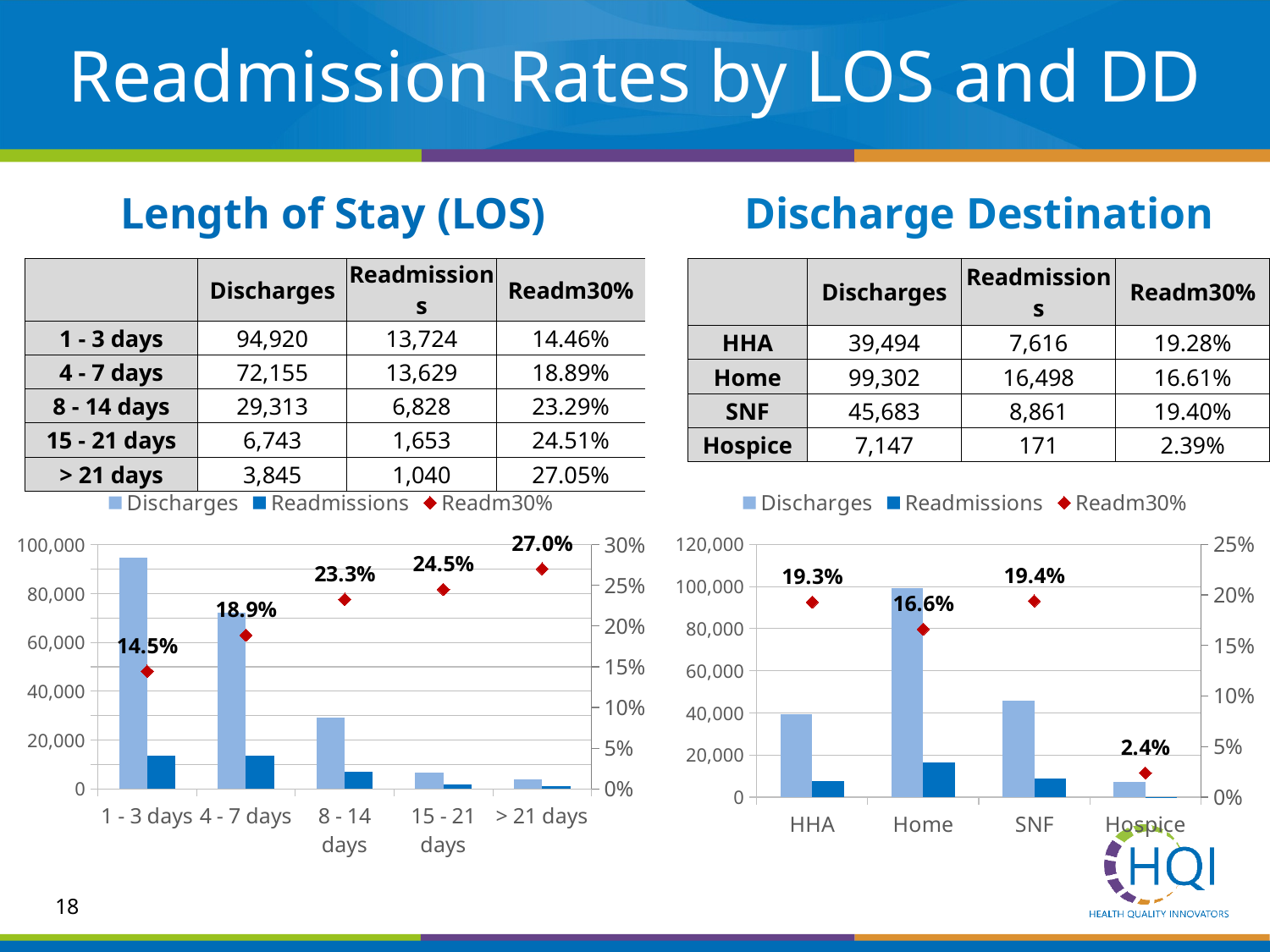
In the Length of Stay (LOS) chart, what is the difference in Readm30% between > 21 days and 1 - 3 days? 12.5 percentage points In the Discharge Destination chart, what is the Readm30% value for Hospice? 2.4% How many series does the legend of the Discharge Destination chart list? 3 In the Discharge Destination chart, which has more Discharges, Home or SNF? Home In the Discharge Destination chart, is the Discharges value for Home greater or less than 80,000? greater In the Length of Stay (LOS) chart, which length-of-stay category has the highest Readm30%? > 21 days In the Length of Stay (LOS) chart, which length-of-stay category has the lowest Readm30%? 1 - 3 days How many length-of-stay categories are shown on the x axis of the Length of Stay (LOS) chart? 5 In the Length of Stay (LOS) chart, is the Discharges value for 1 - 3 days greater or less than 80,000? greater In the Length of Stay (LOS) chart, does the Readm30% rise or fall as length of stay increases along the x axis? rises In the Discharge Destination chart, which discharge destination has the lowest Readm30%? Hospice In the Length of Stay (LOS) chart, what is the Readm30% value for 8 - 14 days? 23.3%